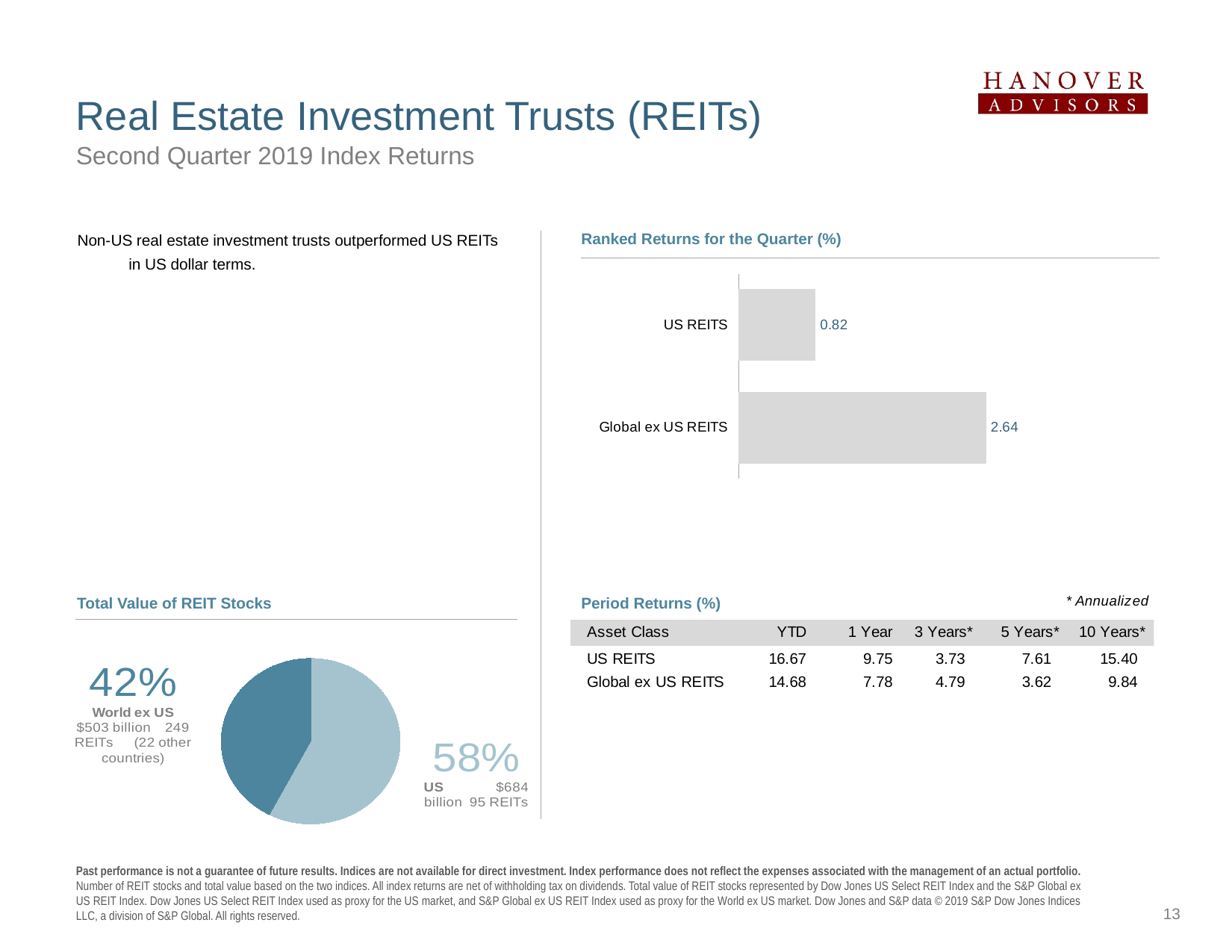
In the Ranked Returns for the Quarter (%) chart, what is the value for US REITS? 0.82 In the Ranked Returns for the Quarter (%) chart, which category has the lowest value? US REITS In the Ranked Returns for the Quarter (%) chart, what is the value for Global ex US REITS? 2.64 In the Ranked Returns for the Quarter (%) chart, what is the difference between the Global ex US REITS value and the US REITS value? 1.82 What kind of chart is the Total Value of REIT Stocks chart? Pie chart In the Total Value of REIT Stocks chart, which slice is larger: US or World ex US? US In the Total Value of REIT Stocks chart, what share of the pie is US? 58% What kind of chart is the Ranked Returns for the Quarter (%) chart? Bar chart How many categories are shown in the Ranked Returns for the Quarter (%) chart? 2 In the Total Value of REIT Stocks chart, what share of the pie is World ex US? 42% In the Ranked Returns for the Quarter (%) chart, which is larger: US REITS or Global ex US REITS? Global ex US REITS In the Ranked Returns for the Quarter (%) chart, which category has the highest value? Global ex US REITS